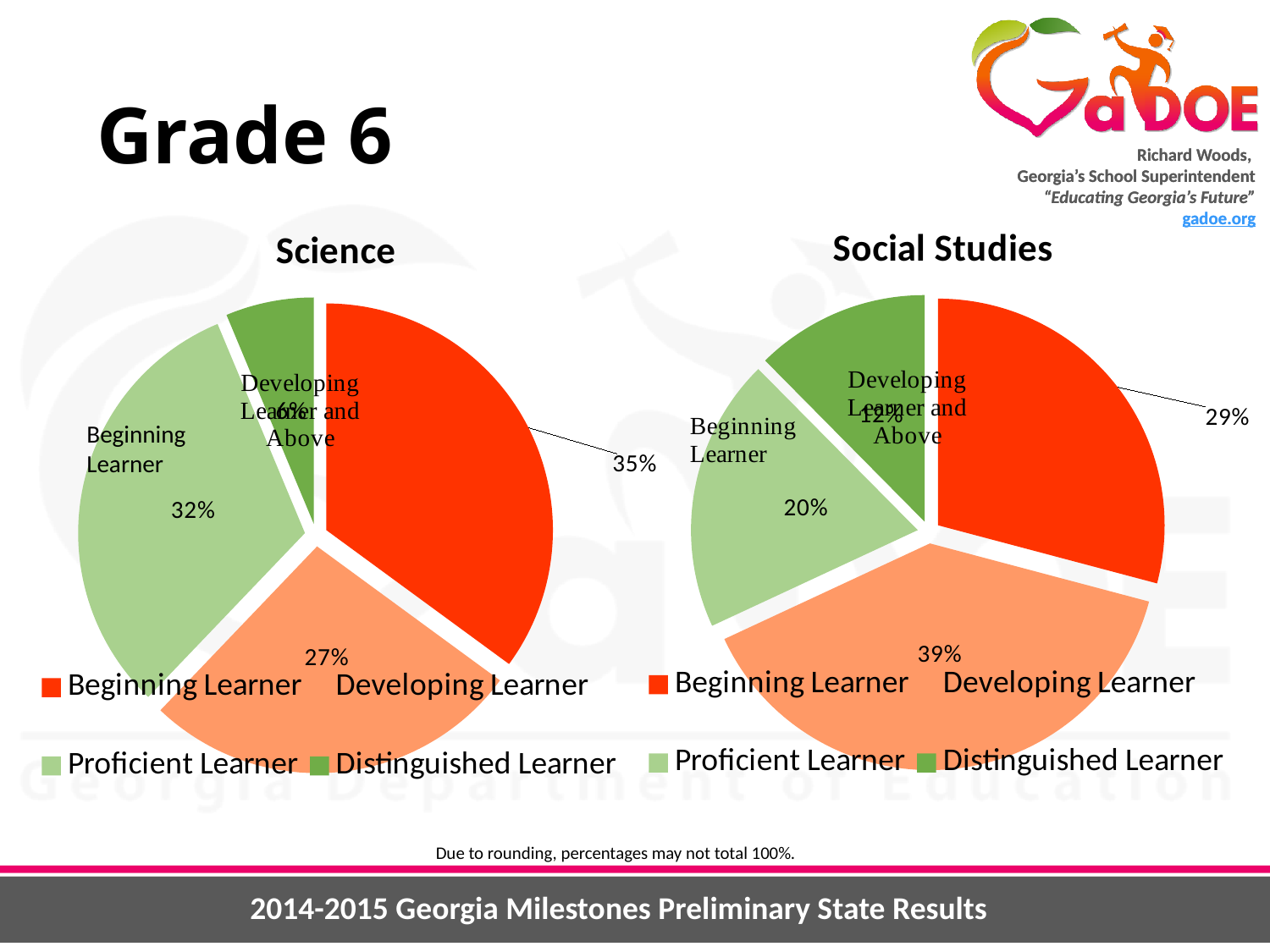
In the Social Studies pie chart, which category has the largest slice? Developing Learner What type of chart is used for the Science and Social Studies results on this slide? Pie chart In the Social Studies pie chart, what percentage is shown for Beginning Learner? 29% In the Social Studies pie chart, how many percentage points larger is Developing Learner than Beginning Learner? 10 percentage points In the Science pie chart, what percentage is shown for Beginning Learner? 35% In the Science pie chart, which is larger: Proficient Learner or Developing Learner? Proficient Learner In the Science pie chart, which category has the largest slice? Beginning Learner In the Social Studies pie chart, what percentage is shown for Developing Learner? 39% In the Social Studies pie chart, what percentage is shown for Proficient Learner? 20% In the Science pie chart, what percentage is shown for Developing Learner? 27% In the Science pie chart, which category has the smallest slice? Distinguished Learner In the Science pie chart, what percentage is shown for Proficient Learner? 32%